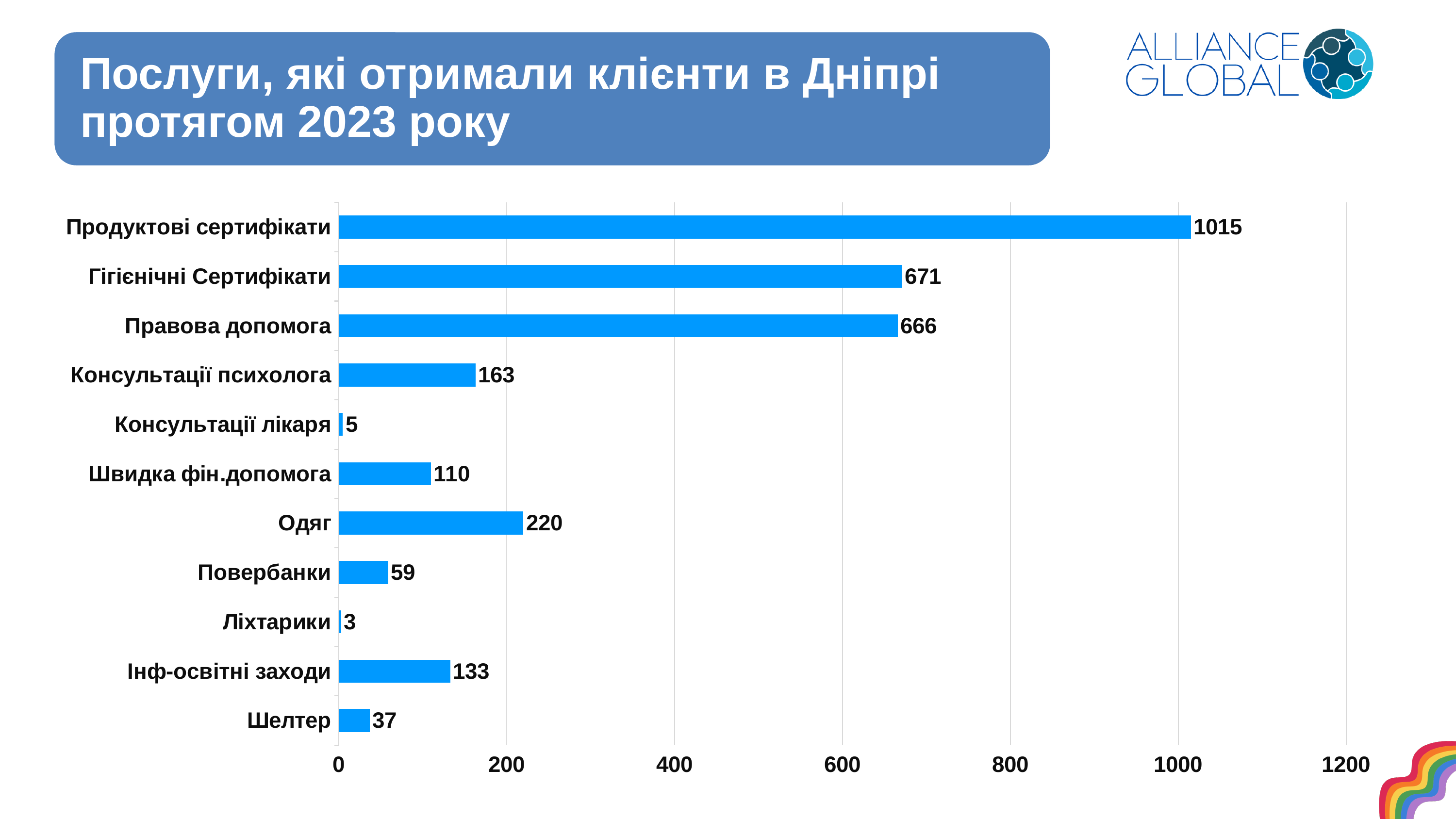
How many categories are shown in the chart? 11 What kind of chart is shown on the slide? bar chart Which is larger, the value for Інф-освітні заходи or the value for Повербанки? Інф-освітні заходи What is the value for Продуктові сертифікати? 1015 What is the value for Шелтер? 37 Is the value for Правова допомога greater or less than 600? greater What is the difference between the values for Одяг and Швидка фін.допомога? 110 Which category has the lowest value? Ліхтарики What is the value for Консультації психолога? 163 What is the title of the slide? Послуги, які отримали клієнти в Дніпрі протягом 2023 року What is the difference between the values for Гігієнічні Сертифікати and Правова допомога? 5 Which category has the highest value? Продуктові сертифікати